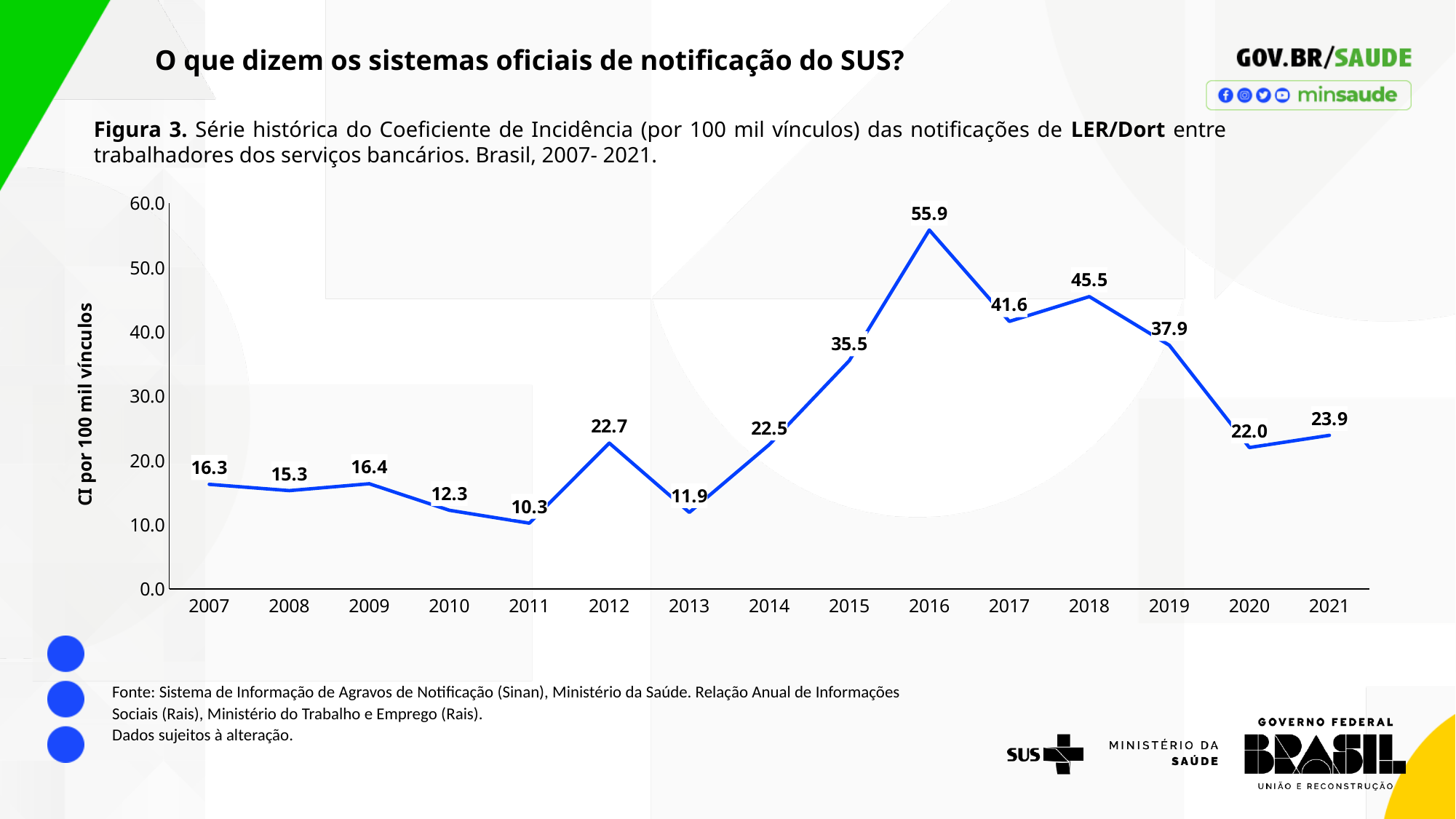
Do the values rise or fall from 2016 to 2020? fall What is the incidence coefficient for 2011? 10.3 What is the incidence coefficient for 2021? 23.9 Which year has the lowest incidence coefficient? 2011 What is the difference between the values for 2016 and 2017? 14.3 Which year has a higher value, 2018 or 2019? 2018 What is the incidence coefficient for 2016? 55.9 What is the difference between the values for 2021 and 2020? 1.9 Which year has the highest incidence coefficient? 2016 Is the value for 2015 greater or less than 30.0? greater What kind of chart is shown? line chart How many years are plotted on the x axis? 15